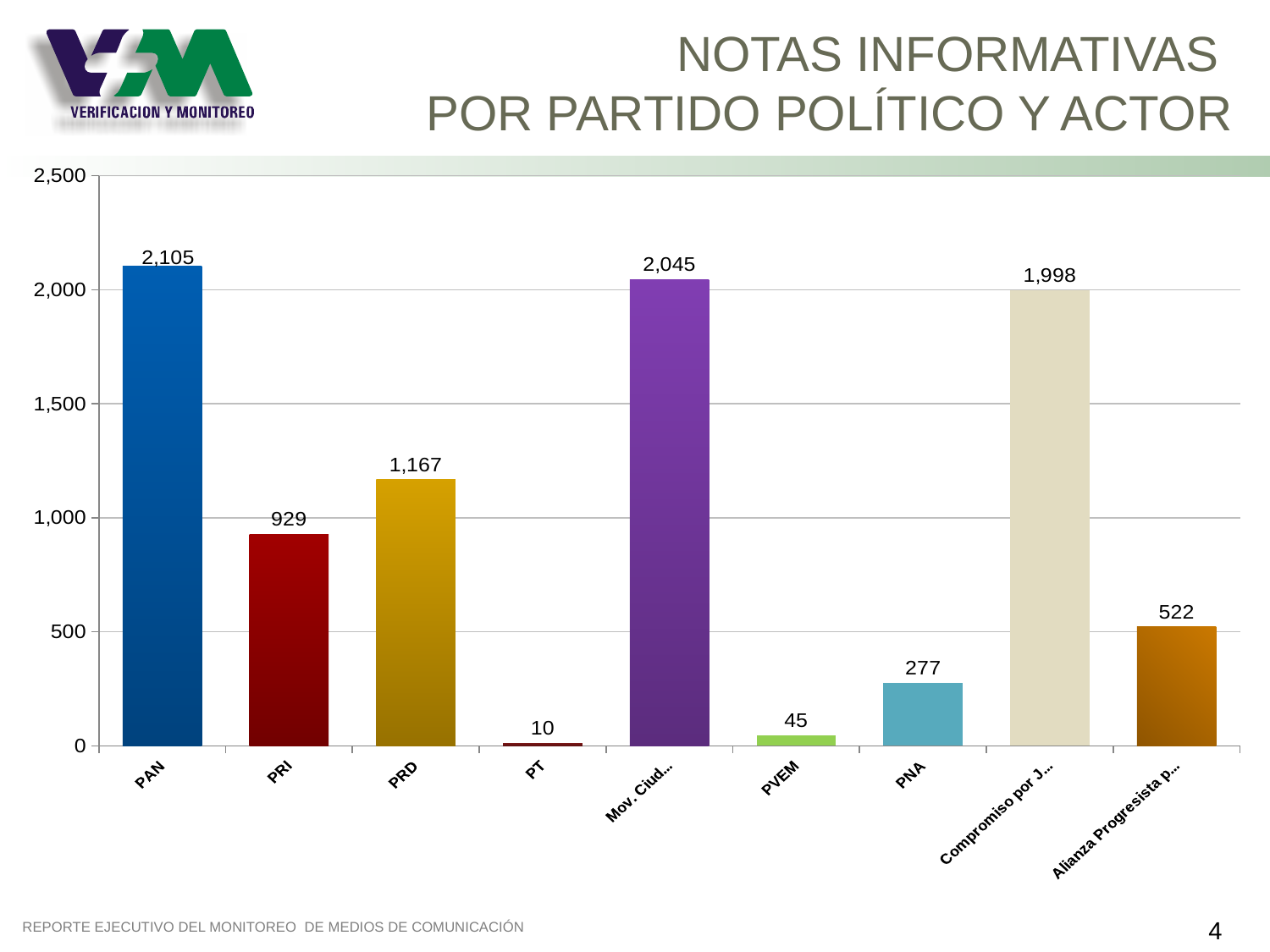
What is the value for PNA? 277 Which category has the highest value? PAN What is the value for PAN? 2,105 How many categories are shown on the x axis? 9 Which is larger, the value for PRI or the value for the bar labelled 'Alianza Progresista p...'? PRI What is the value for PVEM? 45 What kind of chart is shown on the slide? Bar chart Which category has the lowest value? PT What is the difference between the values for PAN and the bar labelled 'Mov. Ciud...'? 60 What is the difference between the values for PRD and PRI? 238 What is the value for PRD? 1,167 What is the title of the slide? NOTAS INFORMATIVAS POR PARTIDO POLÍTICO Y ACTOR